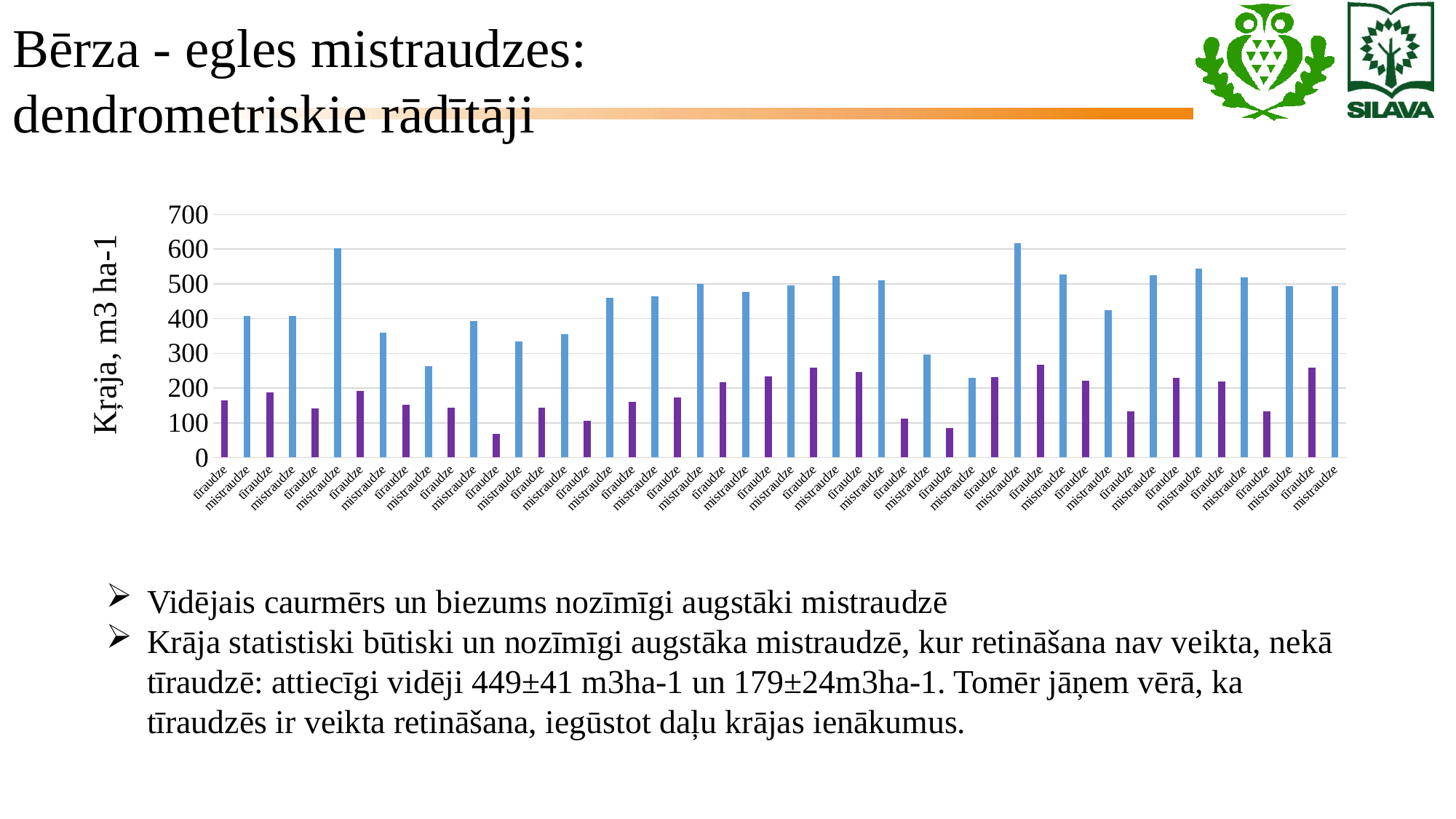
Which two category labels alternate along the horizontal axis of the chart? tīraudze and mistraudze What is the label of the vertical axis of the chart? Krāja, m3 ha-1 Is the lowest purple (tīraudze) bar greater or less than 100? less What kind of chart is shown on the slide? bar chart Is the tallest blue (mistraudze) bar greater or less than 500? greater Is the tallest purple (tīraudze) bar greater or less than 300? less Are the mistraudze bars generally higher or lower than the neighbouring tīraudze bars? higher What is the highest tick value shown on the vertical axis of the chart? 700 Which is larger in the first pair of bars on the left: the tīraudze bar or the mistraudze bar? mistraudze Do the mistraudze bars show a consistent rising or falling trend from left to right, or no clear trend? no clear trend